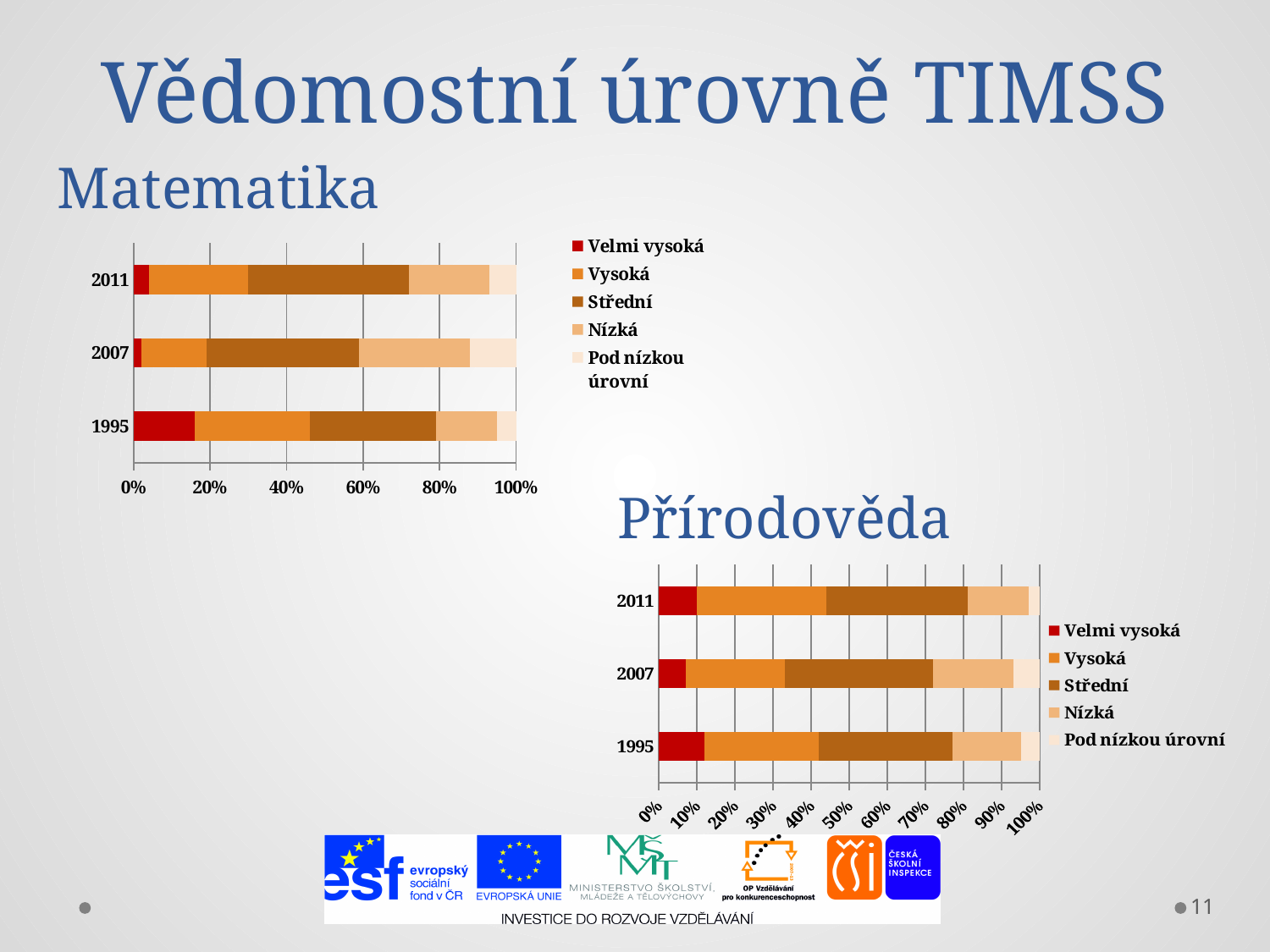
In the Matematika chart, which year has the smallest Velmi vysoká segment? 2007 In the Matematika chart, is the Nízká segment for 2007 larger or smaller than the Nízká segment for 1995? larger In the Matematika chart, is the Velmi vysoká value for 1995 greater or less than 10%? greater What kind of chart is the Matematika chart? stacked bar chart In the Přírodověda chart, which year has the smallest Velmi vysoká segment? 2007 In the Přírodověda chart, is the Velmi vysoká segment for 2011 larger or smaller than the one for 2007? larger How many years are shown on the Matematika chart? 3 How many series does the legend of the Přírodověda chart list? 5 In the Matematika chart, which year has the largest Velmi vysoká segment? 1995 In the Matematika chart, is the Velmi vysoká value for 1995 greater or less than 20%? less Which legend entry is shown in the darkest red colour on the Přírodověda chart? Velmi vysoká What is the last legend entry listed for the Matematika chart? Pod nízkou úrovní